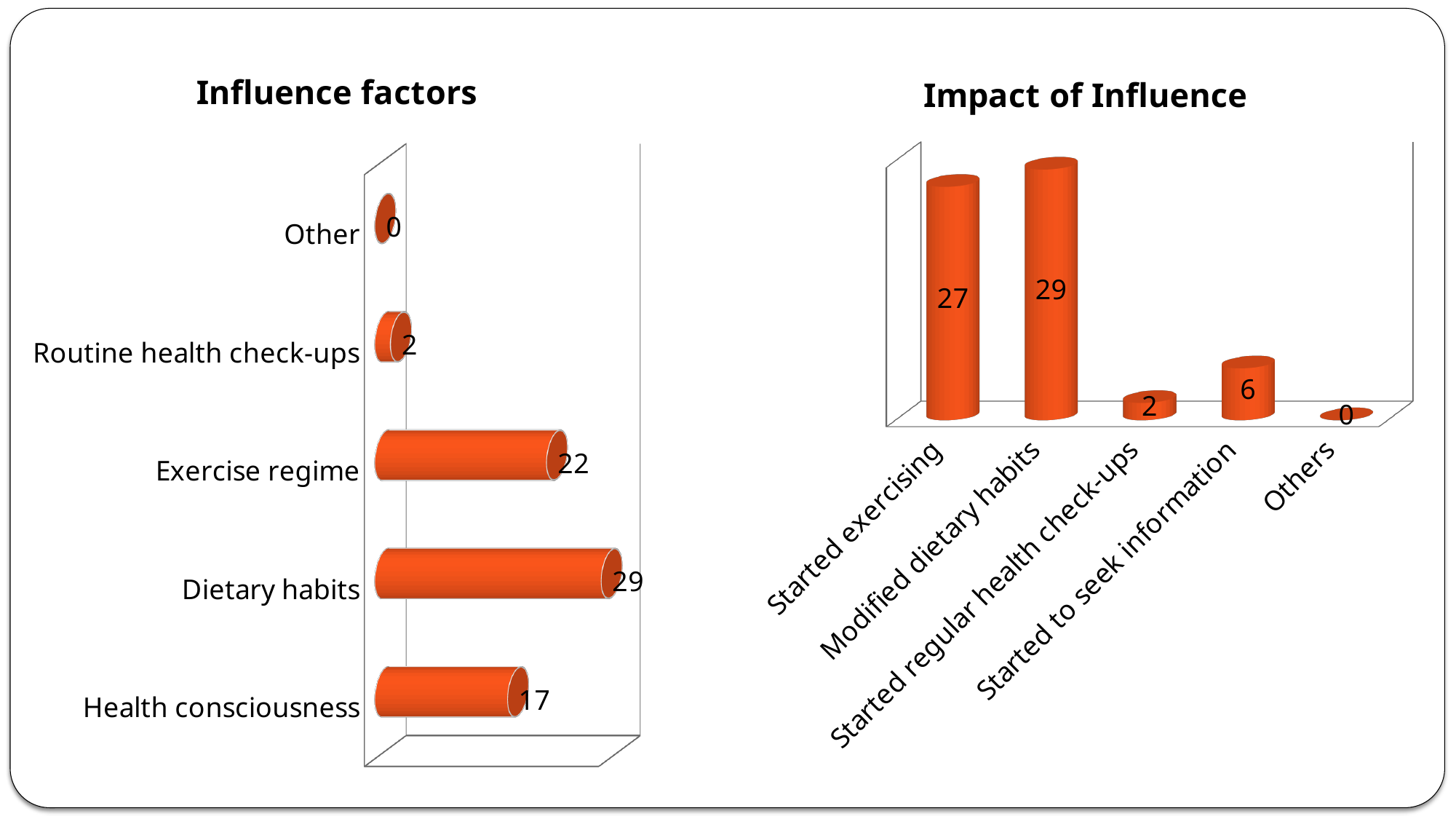
In the 'Impact of Influence' chart, how many categories are shown? 5 In the 'Influence factors' chart, what is the value for Dietary habits? 29 In the 'Influence factors' chart, what is the difference between Dietary habits and Exercise regime? 7 In the 'Impact of Influence' chart, which is larger: Started regular health check-ups or Started to seek information? Started to seek information In the 'Impact of Influence' chart, what is the value for Started to seek information? 6 In the 'Influence factors' chart, which category has the highest value? Dietary habits In the 'Influence factors' chart, what is the value for Health consciousness? 17 What kind of chart is the 'Influence factors' chart? Bar chart In the 'Impact of Influence' chart, what is the value for Started exercising? 27 In the 'Impact of Influence' chart, what is the difference between Modified dietary habits and Started exercising? 2 In the 'Impact of Influence' chart, which category has the highest value? Modified dietary habits In the 'Influence factors' chart, how many categories are shown? 5